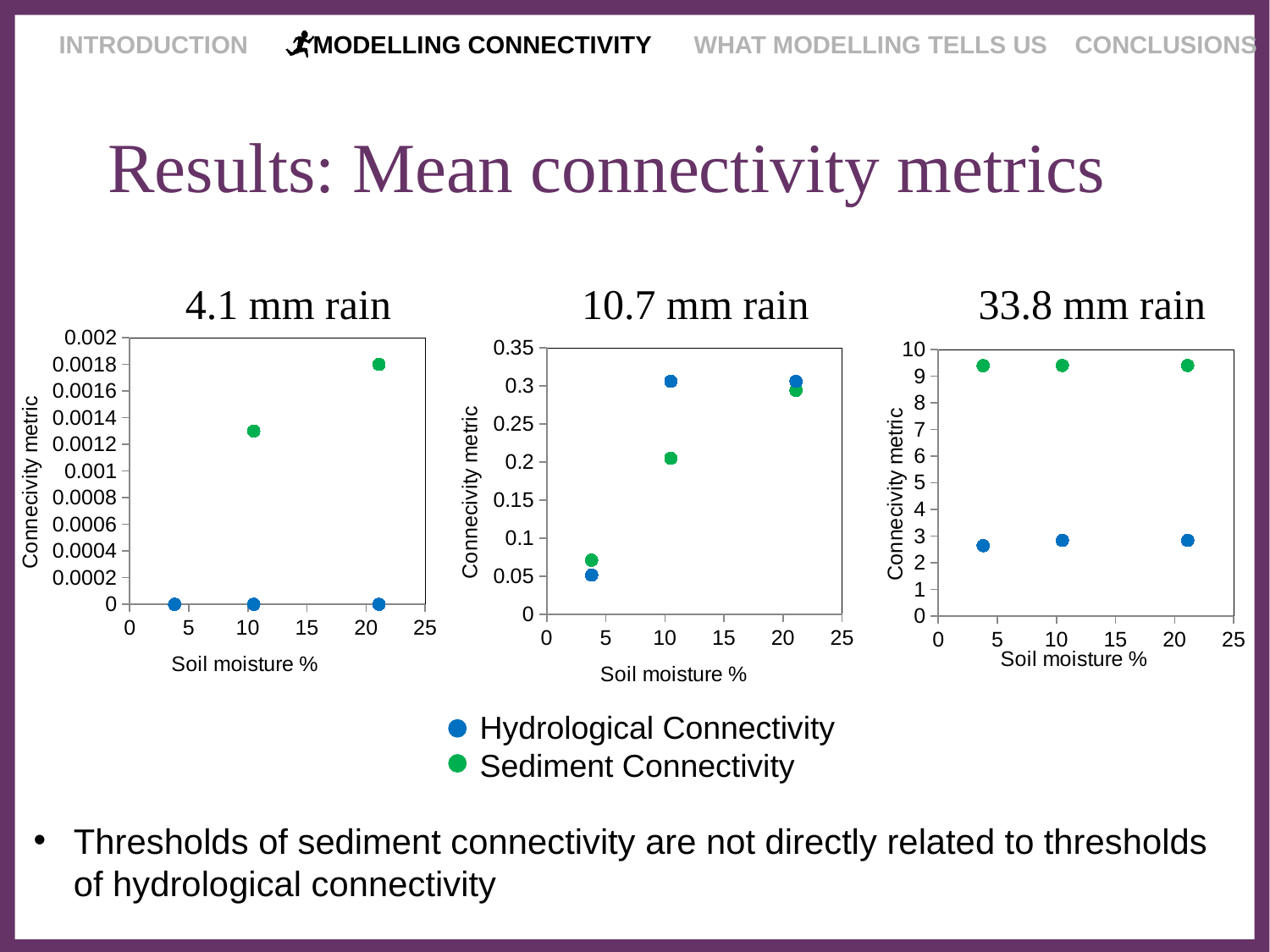
In the "10.7 mm rain" chart, how many Hydrological Connectivity points are plotted? 3 In the "33.8 mm rain" chart, which series has the larger value at about 10% soil moisture, Hydrological Connectivity or Sediment Connectivity? Sediment Connectivity In the "10.7 mm rain" chart, is the Sediment Connectivity value at about 4% soil moisture greater or less than 0.1? less In the "10.7 mm rain" chart, do the Sediment Connectivity values rise or fall as soil moisture increases? rise What kind of chart is the "4.1 mm rain" chart? scatter chart What are the two series named in the legend? Hydrological Connectivity and Sediment Connectivity In the "4.1 mm rain" chart, which series has the larger value at about 21% soil moisture, Hydrological Connectivity or Sediment Connectivity? Sediment Connectivity In the "4.1 mm rain" chart, what is the Hydrological Connectivity value at about 10% soil moisture? 0 What is the x-axis label on the "33.8 mm rain" chart? Soil moisture % In the "33.8 mm rain" chart, is the Sediment Connectivity value at about 21% soil moisture greater or less than 8? greater In the "33.8 mm rain" chart, is the Hydrological Connectivity value at about 10% soil moisture greater or less than 4? less How many series does the shared legend list for the charts? 2